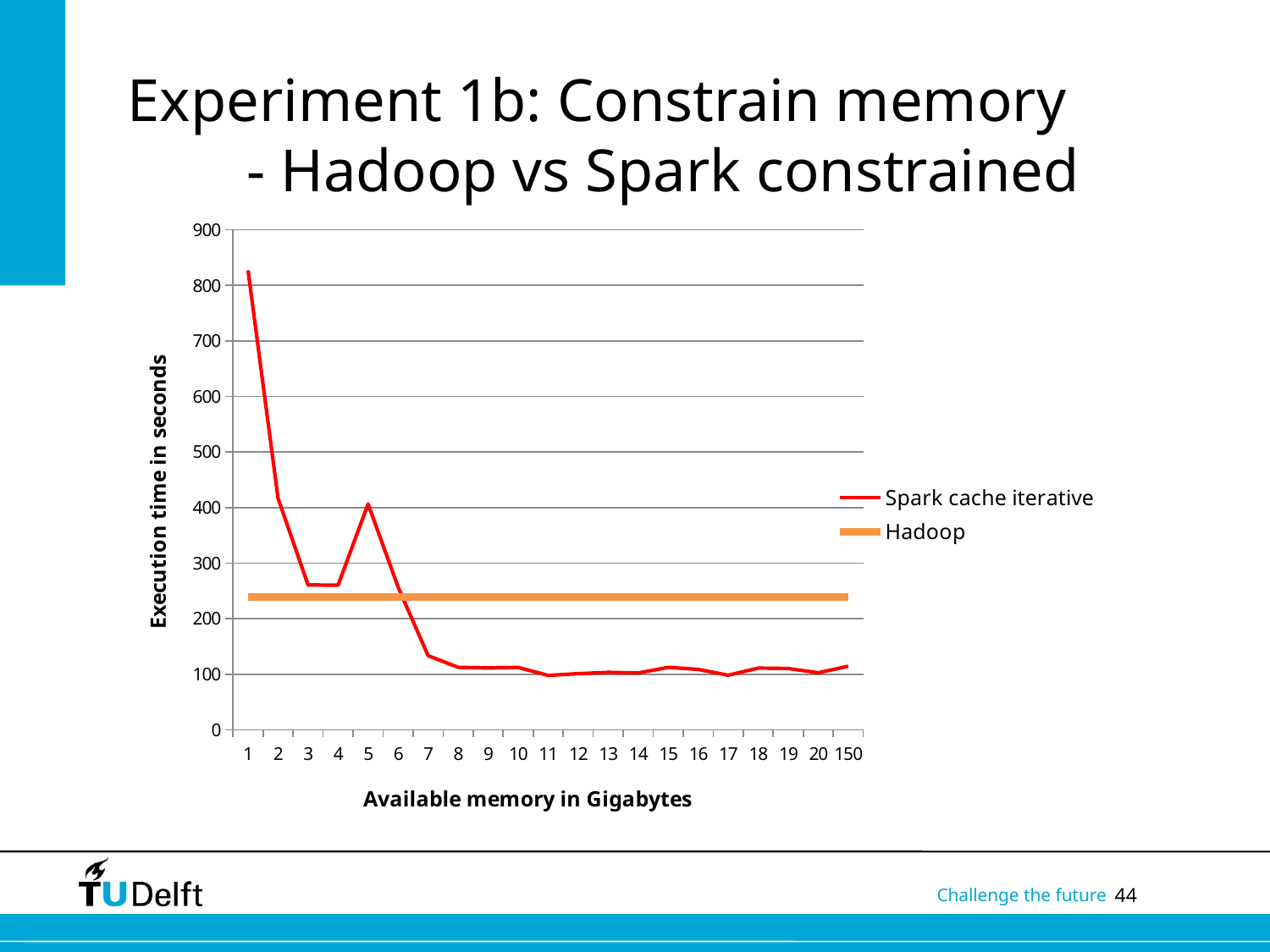
What kind of chart is shown on the slide? line chart At which available memory value is the Spark cache iterative execution time highest? 1 What is the title of the y axis? Execution time in seconds Does the Spark cache iterative execution time rise or fall from 1 GB to 3 GB? fall How many memory values are shown along the x axis? 21 Is the Spark cache iterative execution time at 10 GB greater or less than 200? less At 2 GB of available memory, which series has the higher execution time, Spark cache iterative or Hadoop? Spark cache iterative Is the Spark cache iterative execution time at 1 GB greater or less than 700? greater Is the Spark cache iterative execution time at 5 GB greater or less than 300? greater At 15 GB of available memory, which series has the higher execution time, Spark cache iterative or Hadoop? Hadoop How many series does the legend list? 2